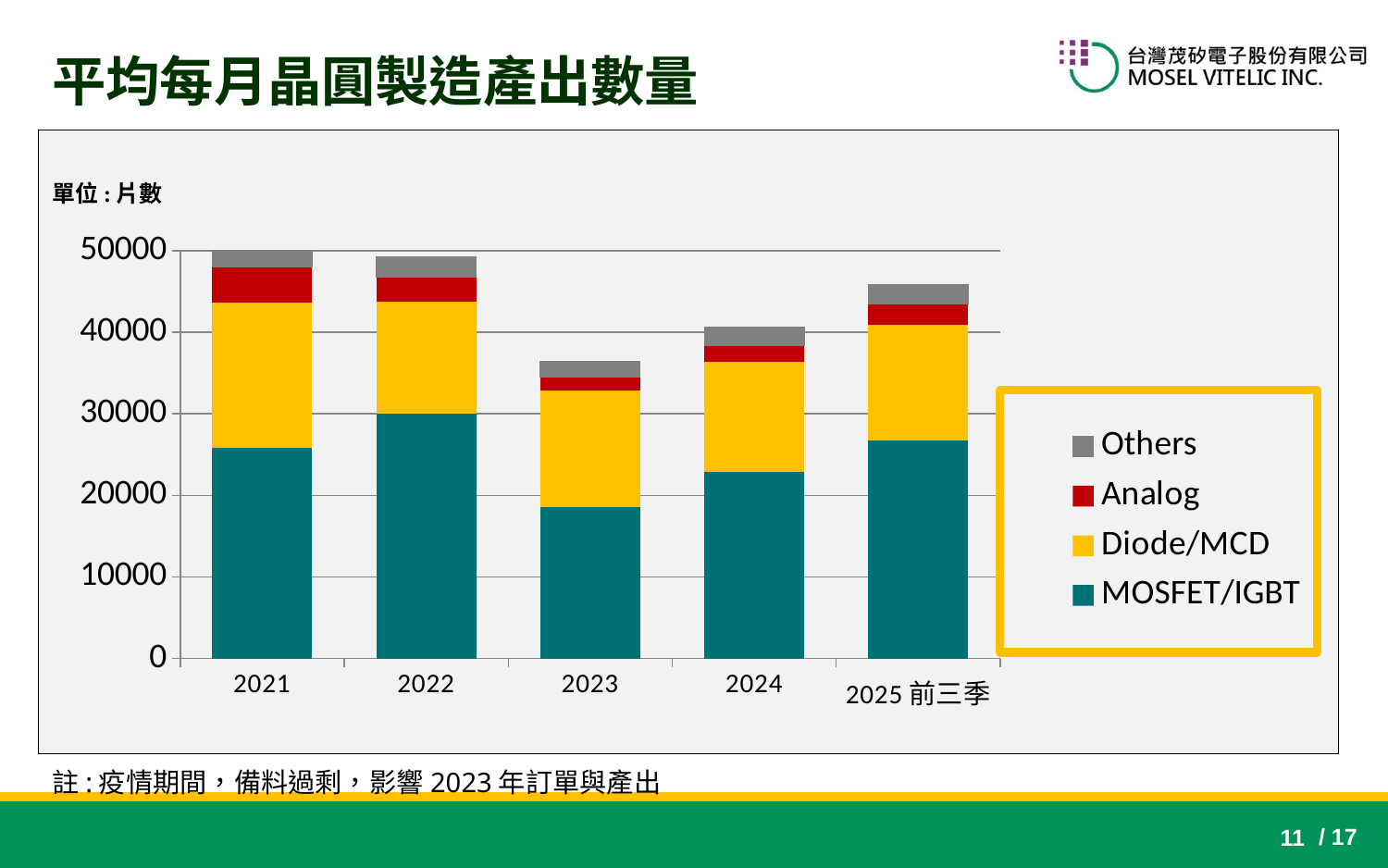
Is the MOSFET/IGBT value for 2023 greater or less than 20000? less Is the total for 2023 greater or less than 40000? less Do the total bar heights rise or fall from 2023 to 2025 前三季? rise Which is larger, the MOSFET/IGBT value for 2022 or for 2023? 2022 How many series does the chart legend list? 4 Is the MOSFET/IGBT value for 2021 greater or less than 20000? greater What kind of chart is shown on the slide? stacked bar chart How many categories are shown on the x axis of the chart? 5 Which year has the lowest total stacked bar? 2023 Which series are listed in the chart legend? Others, Analog, Diode/MCD, MOSFET/IGBT What unit label is shown above the chart? 單位 : 片數